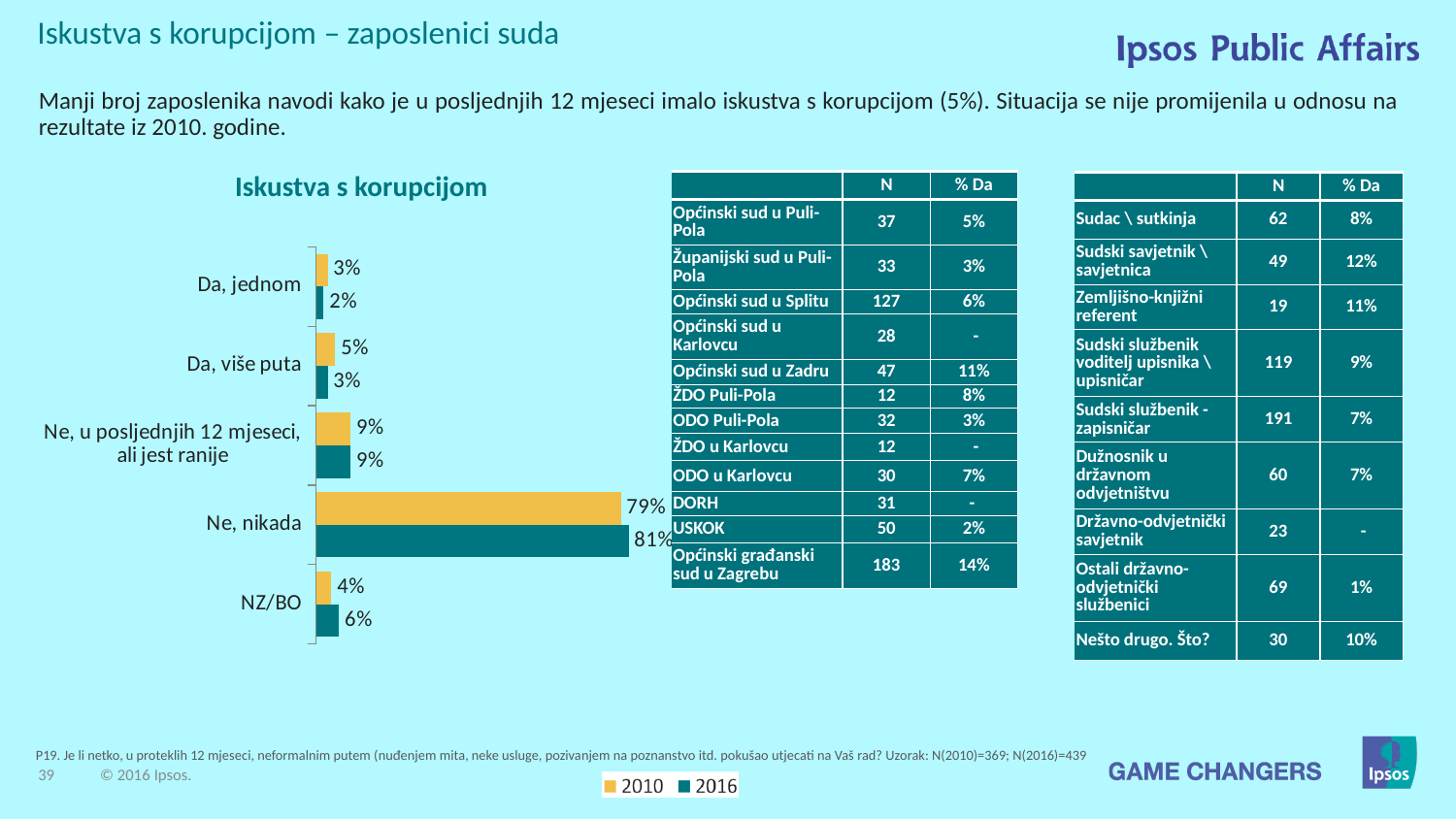
How many categories are shown in the "Iskustva s korupcijom" chart? 5 How many series does the legend of the "Iskustva s korupcijom" chart list? 2 In the "Iskustva s korupcijom" chart, what is the 2010 value for "Da, više puta"? 5% In the "Iskustva s korupcijom" chart, what is the 2016 value for "Ne, nikada"? 81% In the "Iskustva s korupcijom" chart, what is the 2016 value for "NZ/BO"? 6% In the "Iskustva s korupcijom" chart, what is the difference between the 2016 and 2010 values for "Ne, nikada"? 2% What type of chart is "Iskustva s korupcijom"? bar chart In the "Iskustva s korupcijom" chart, is the 2010 or the 2016 value larger for "NZ/BO"? 2016 In the "Iskustva s korupcijom" chart, what is the 2010 value for "Da, jednom"? 3% Which category has the lowest 2016 value in the "Iskustva s korupcijom" chart? Da, jednom Which series is shown in yellow in the "Iskustva s korupcijom" chart? 2010 Which category has the highest 2016 value in the "Iskustva s korupcijom" chart? Ne, nikada